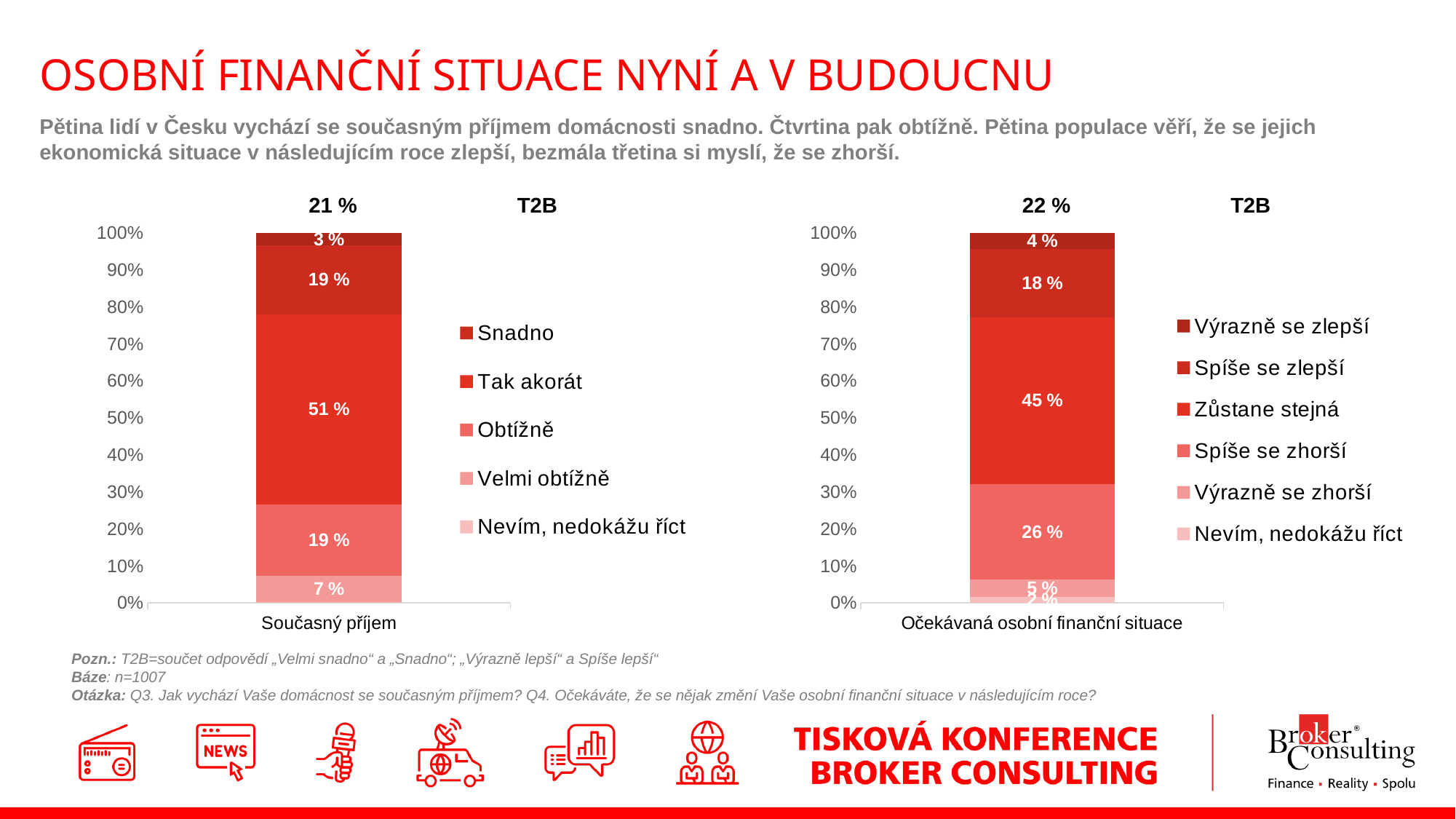
What type of chart is used on this slide? stacked bar chart In the right chart (Očekávaná osobní finanční situace), what is the difference between Zůstane stejná and Spíše se zhorší? 19 % How many entries does the legend of the right chart (Očekávaná osobní finanční situace) list? 6 What is the T2B value shown above the left chart (Současný příjem)? 21 % In the right chart (Očekávaná osobní finanční situace), what is the value for Výrazně se zlepší? 4 % In the left chart (Současný příjem), what is the value of the largest segment of the bar? 51 % In the right chart (Očekávaná osobní finanční situace), which category has the largest share? Zůstane stejná How many entries does the legend of the left chart (Současný příjem) list? 5 What is the T2B value shown above the right chart (Očekávaná osobní finanční situace)? 22 % In the right chart (Očekávaná osobní finanční situace), which is larger: Spíše se zlepší or Spíše se zhorší? Spíše se zhorší In the right chart (Očekávaná osobní finanční situace), what is the value for Spíše se zhorší? 26 % In the right chart (Očekávaná osobní finanční situace), what is the value for Zůstane stejná? 45 %